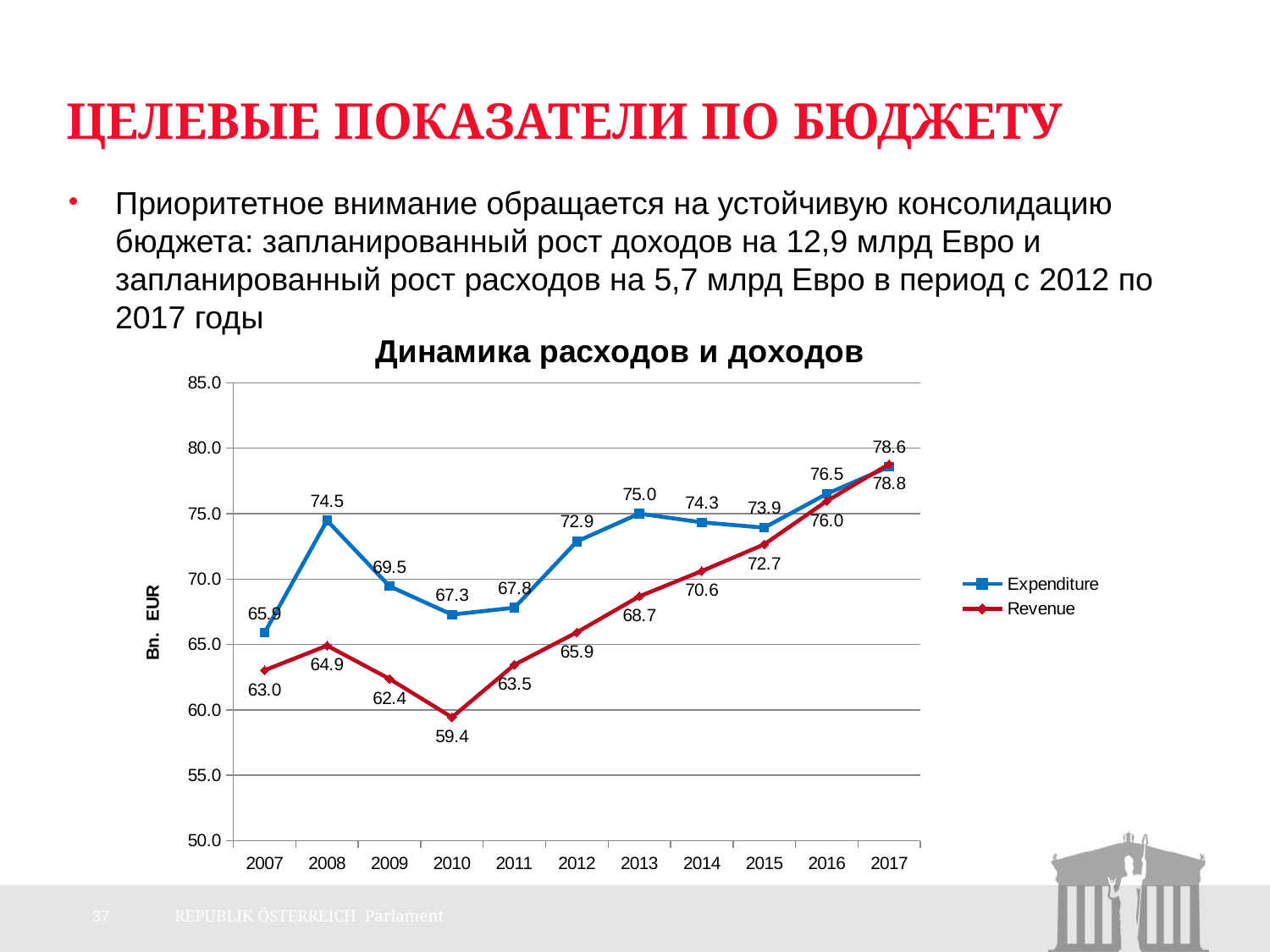
What is the title of the chart? Динамика расходов и доходов Does Revenue rise or fall from 2010 to 2017? rise What type of chart is shown on the slide? line chart Which is larger in 2013, Expenditure or Revenue? Expenditure How many years are shown on the x axis? 11 How many series does the legend list? 2 In which year is Revenue lowest? 2010 What is the Expenditure value for 2008? 74.5 In which year is Expenditure highest? 2017 What is the Revenue value for 2010? 59.4 What is the difference between Expenditure and Revenue in 2012? 7.0 What is the Revenue value for 2014? 70.6